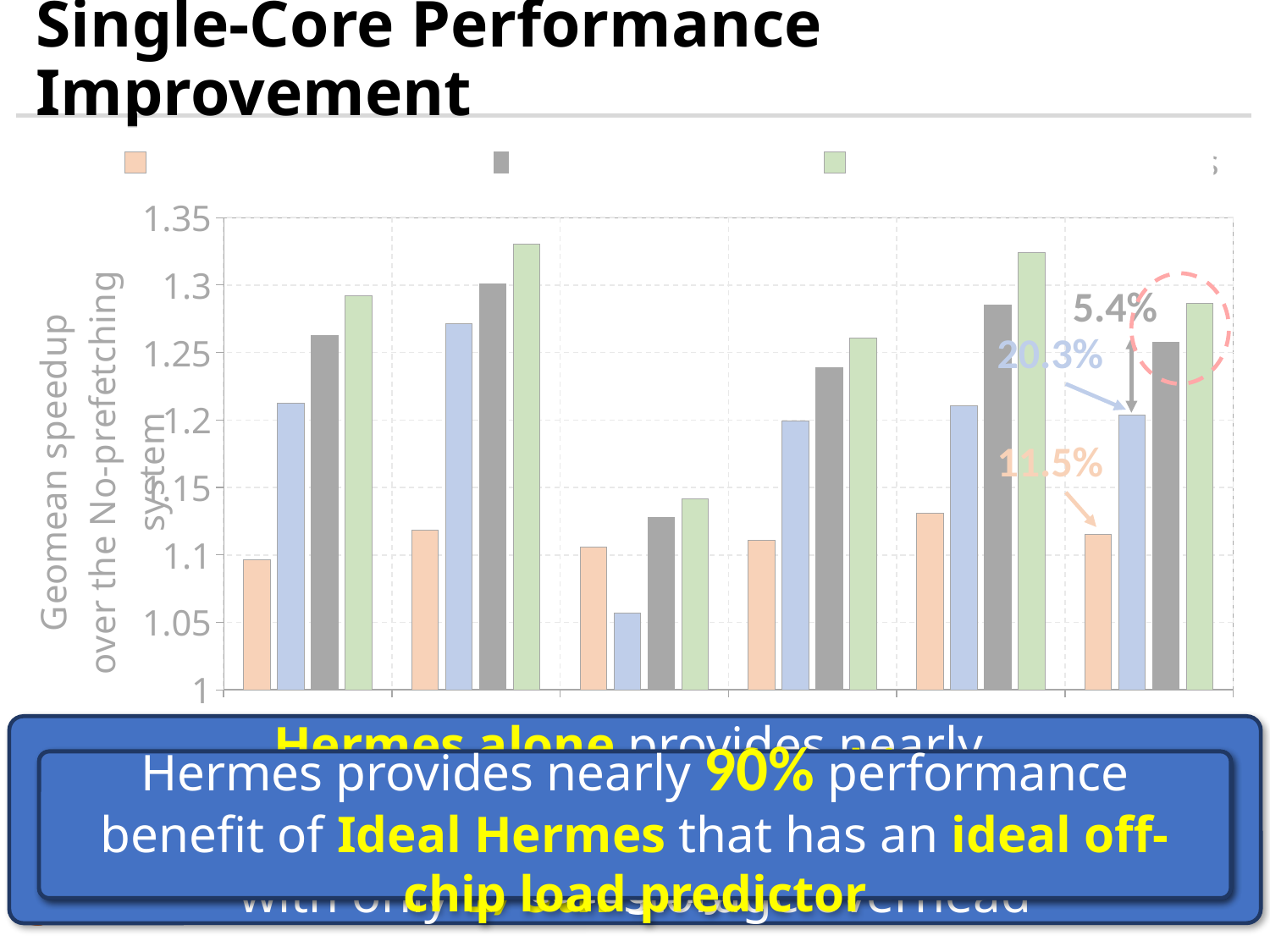
What percentage annotation is shown next to the orange bar in the last group? 11.5% Which bar is the lowest in the whole chart? the blue bar in the third group In the third group, which is larger: the orange bar or the blue bar? the orange bar How many bars are there in each group? 4 Is the value of the green bar in the second group greater or less than 1.3? greater Is the value of the green bar in the first group greater or less than 1.25? greater What is the label of the y axis? Geomean speedup over the No-prefetching system How many groups of bars are plotted along the x axis? 6 What type of chart is shown on the slide? bar chart In the first group, which is larger: the blue bar or the gray bar? the gray bar Is the value of the blue bar in the third group greater or less than 1.1? less Which colour bar is the tallest in every group? green